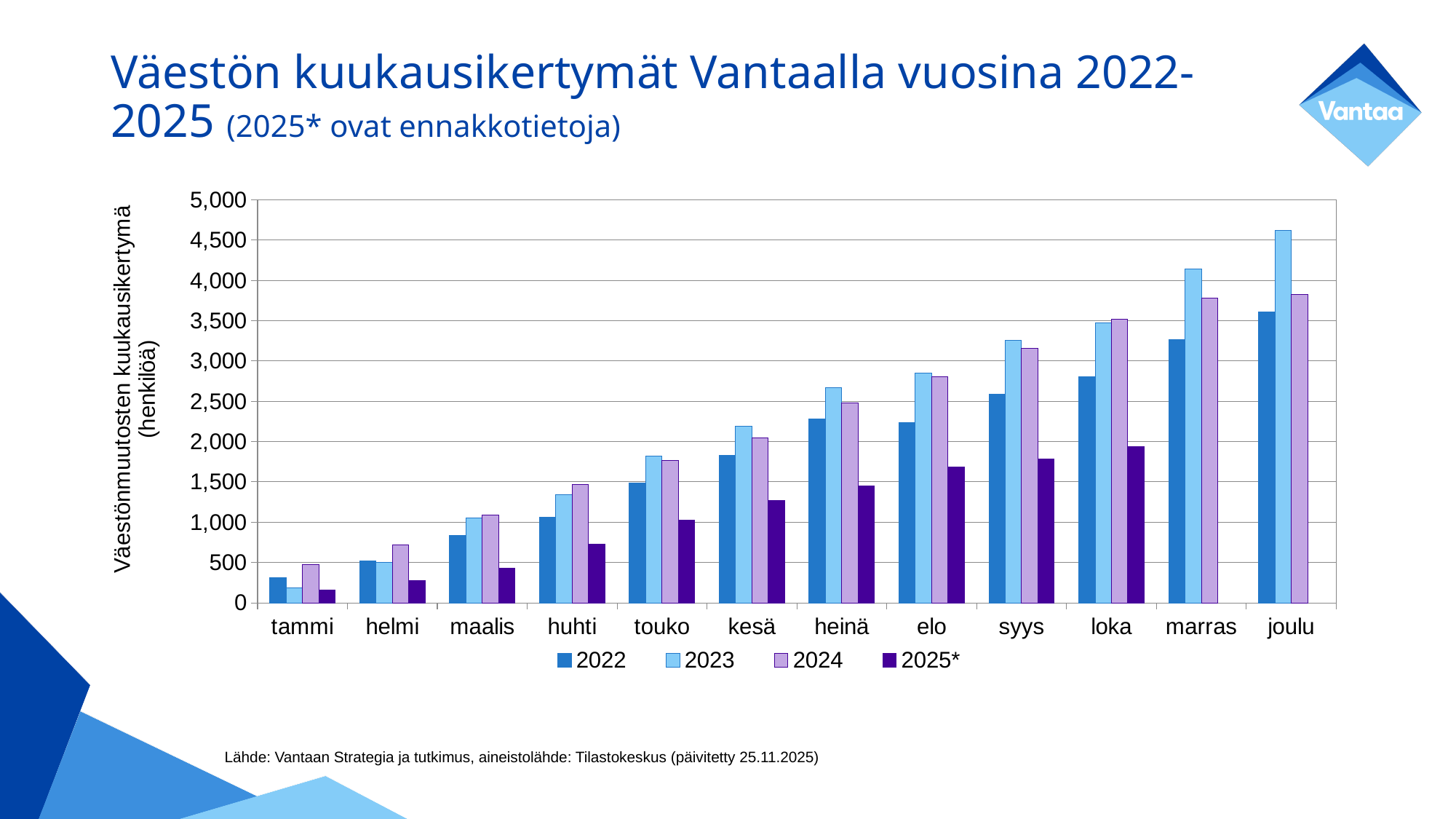
Which series has no bars for marras and joulu? 2025* For tammi, which is larger: the 2022 value or the 2024 value? 2024 What kind of chart is shown on the slide? bar chart Is the 2023 value for joulu greater or less than 4,500? greater Is the 2025* value for loka greater or less than 2,000? less How many series does the legend list? 4 How many months are shown on the x axis? 12 Is the 2022 value for marras greater or less than 3,000? greater In which month is the 2023 value highest? joulu In which month is the 2025* value lowest? tammi For heinä, which is larger: the 2023 value or the 2024 value? 2023 Do the 2023 values rise or fall from tammi to joulu? rise